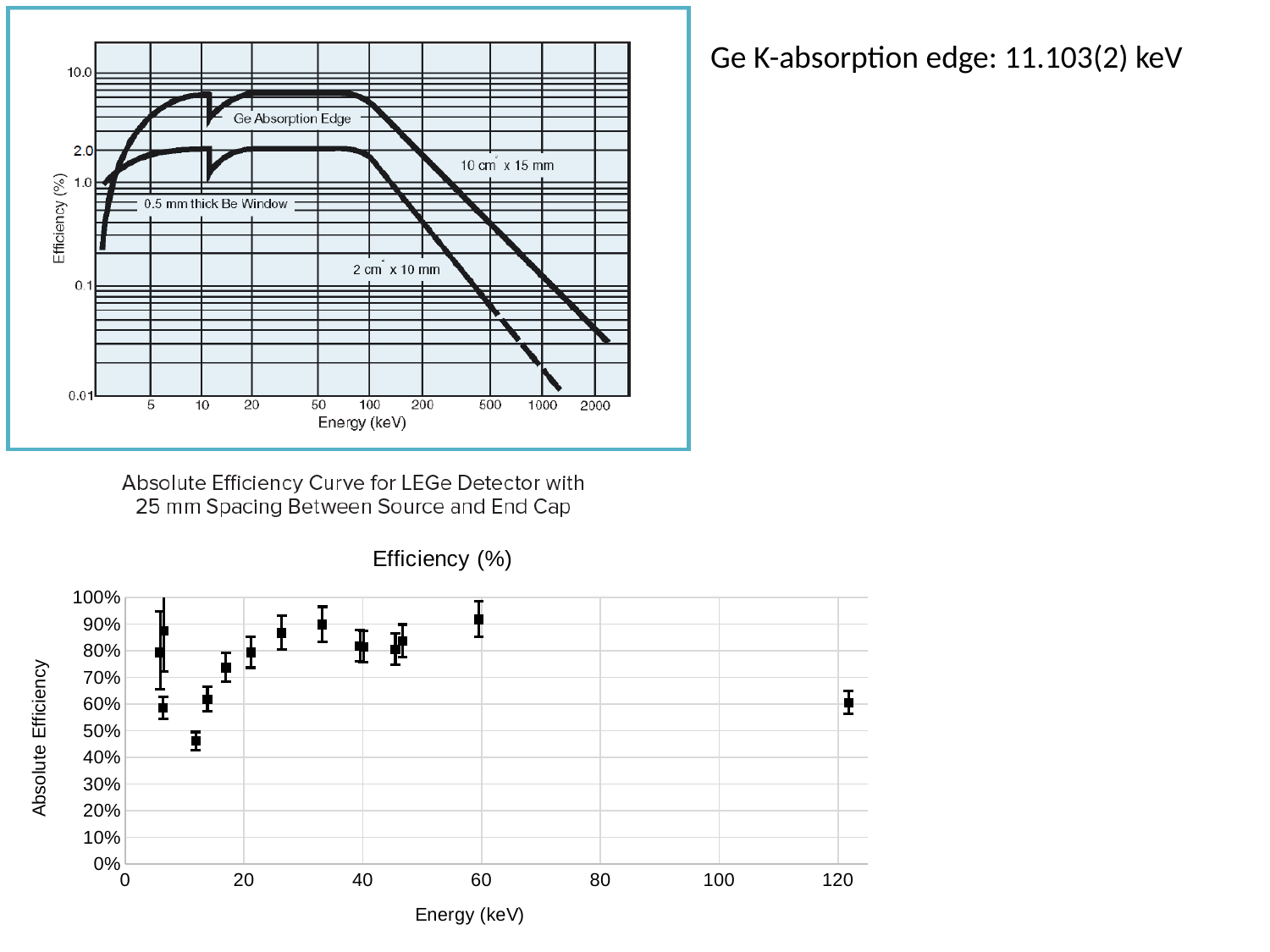
What is the thickness of the Be window noted on the top-left chart (Absolute Efficiency Curve for LEGe Detector)? 0.5 mm In the bottom chart titled "Efficiency (%)", what is the label of the vertical axis? Absolute Efficiency In the top-left chart (Absolute Efficiency Curve for LEGe Detector), is the efficiency of the "10 cm² x 15 mm" curve at 50 keV greater or less than 2.0%? greater In the top-left chart (Absolute Efficiency Curve for LEGe Detector), which detector curve has the higher efficiency: "10 cm² x 15 mm" or "2 cm² x 10 mm"? 10 cm² x 15 mm In the bottom chart titled "Efficiency (%)", is the value for the point near 120 keV greater or less than 70%? less What kind of chart is the bottom chart titled "Efficiency (%)"? Scatter chart In the bottom chart titled "Efficiency (%)", is the value for the point near 60 keV greater or less than 80%? greater In the top-left chart (Absolute Efficiency Curve for LEGe Detector), do the efficiency curves rise or fall as energy increases from 100 keV to 2000 keV? fall In the bottom chart titled "Efficiency (%)", which point is higher: the one near 60 keV or the one near 120 keV? The one near 60 keV